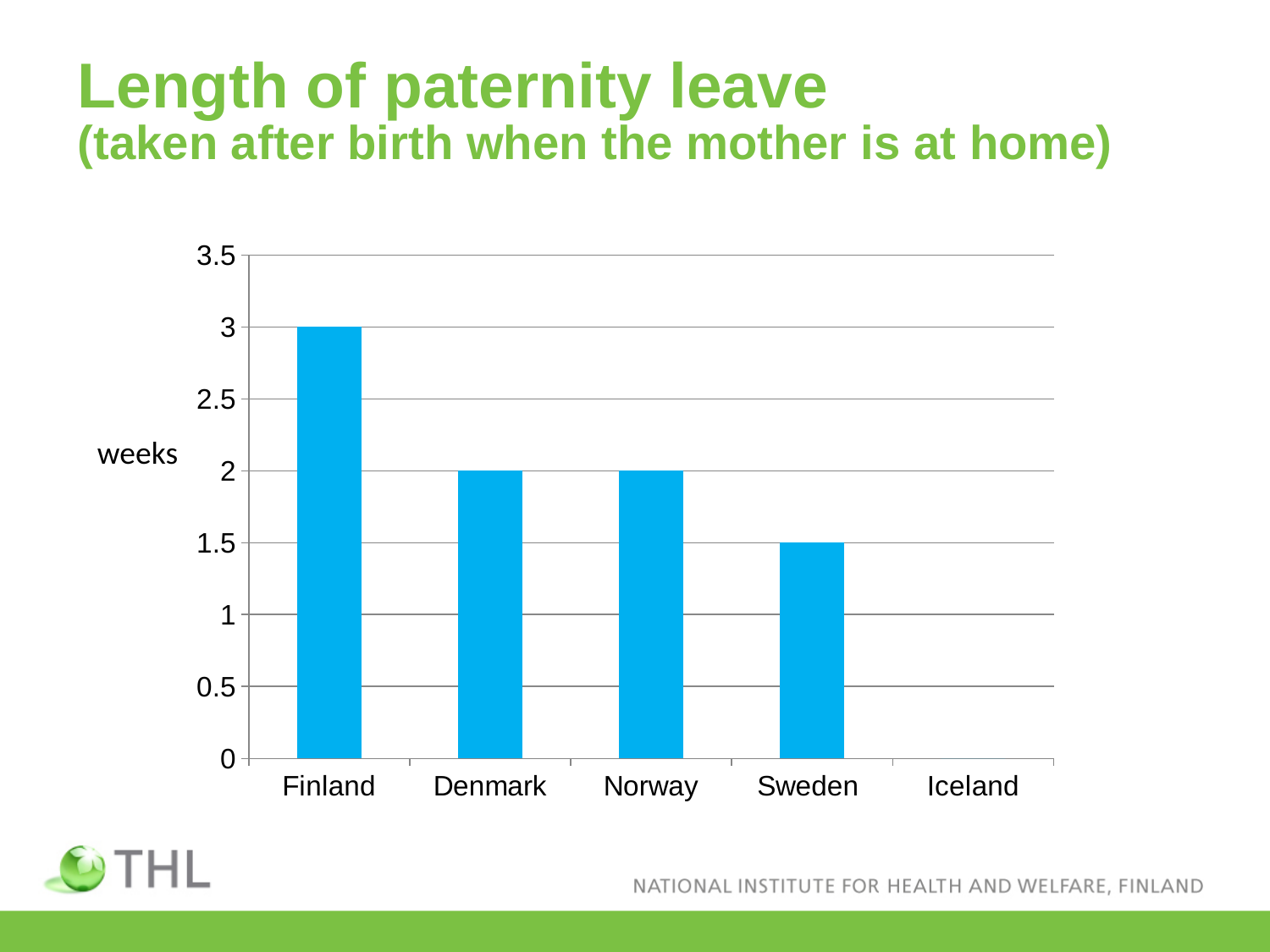
Which has a longer paternity leave, Norway or Sweden? Norway Is the value for Finland greater or less than 2.5? greater What is the length of paternity leave for Denmark, in weeks? 2 What is the title of the chart? Length of paternity leave (taken after birth when the mother is at home) What is the length of paternity leave for Sweden, in weeks? 1.5 How many weeks longer is Finland's paternity leave than Sweden's? 1.5 What kind of chart is shown on the slide? Bar chart Which country has the longest paternity leave? Finland What is the length of paternity leave for Finland, in weeks? 3 Which country has the shortest paternity leave? Iceland How many countries are shown on the x axis? 5 What unit is shown on the y axis label? weeks